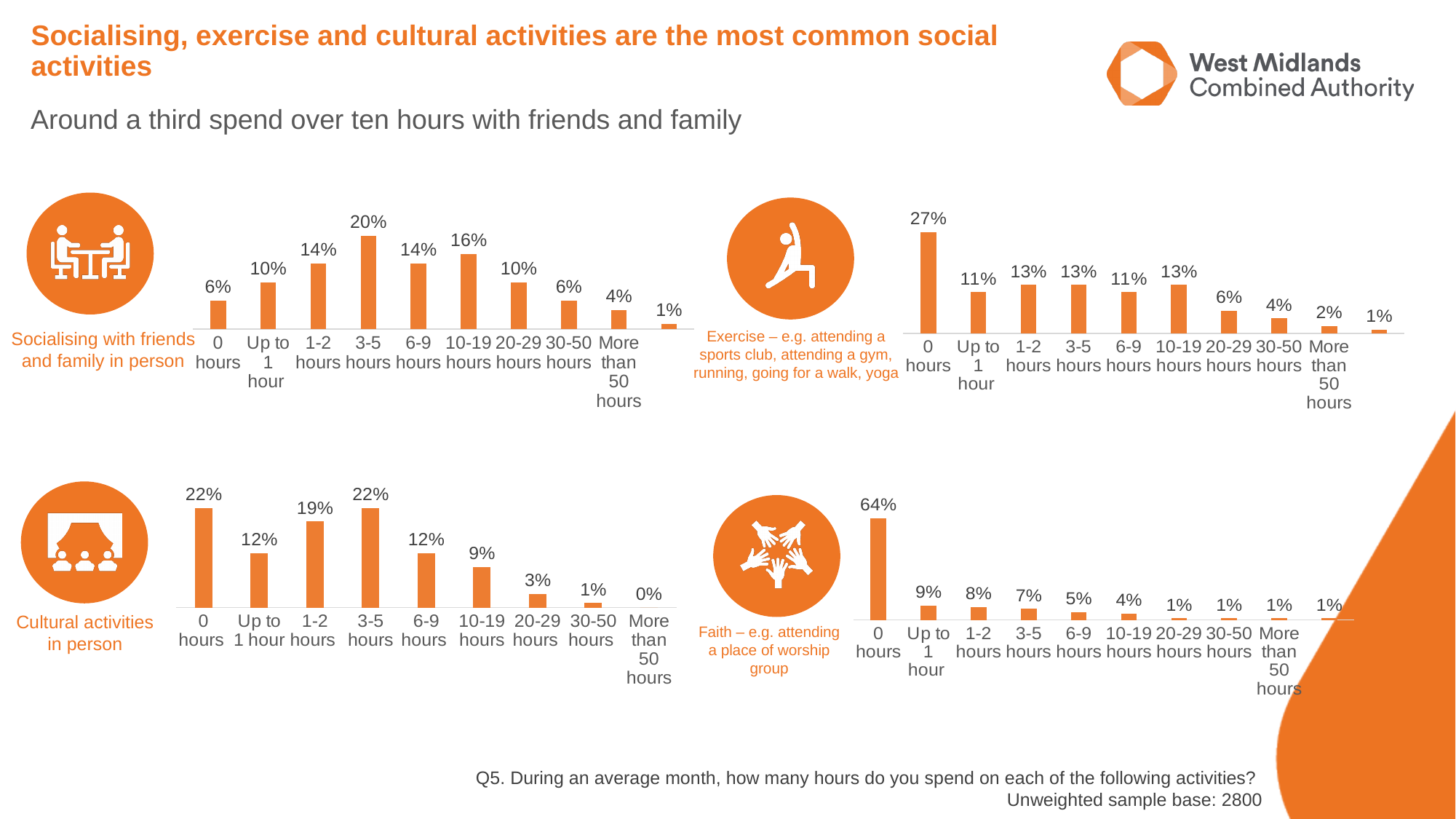
In the 'Socialising with friends and family in person' chart, which category has the highest value? 3-5 hours In the 'Socialising with friends and family in person' chart, what percentage is shown for 3-5 hours? 20% In the 'Cultural activities in person' chart, what percentage is shown for 10-19 hours? 9% In the 'Cultural activities in person' chart, which category has the lowest value? More than 50 hours In the 'Exercise' chart, what is the difference between the value for 0 hours and the value for Up to 1 hour? 16% In the 'Socialising with friends and family in person' chart, what is the difference between the value for 10-19 hours and the value for 20-29 hours? 6% In the 'Faith' chart, do the values generally rise or fall from 0 hours to More than 50 hours? Fall In the 'Faith' chart, what percentage is shown for 0 hours? 64% In the 'Faith' chart, which is larger: the value for 1-2 hours or the value for 6-9 hours? 1-2 hours How many categories are shown on the x axis of the 'Cultural activities in person' chart? 9 In the 'Exercise' chart, what percentage is shown for 0 hours? 27% What type of chart is used for the 'Exercise' data? Bar chart